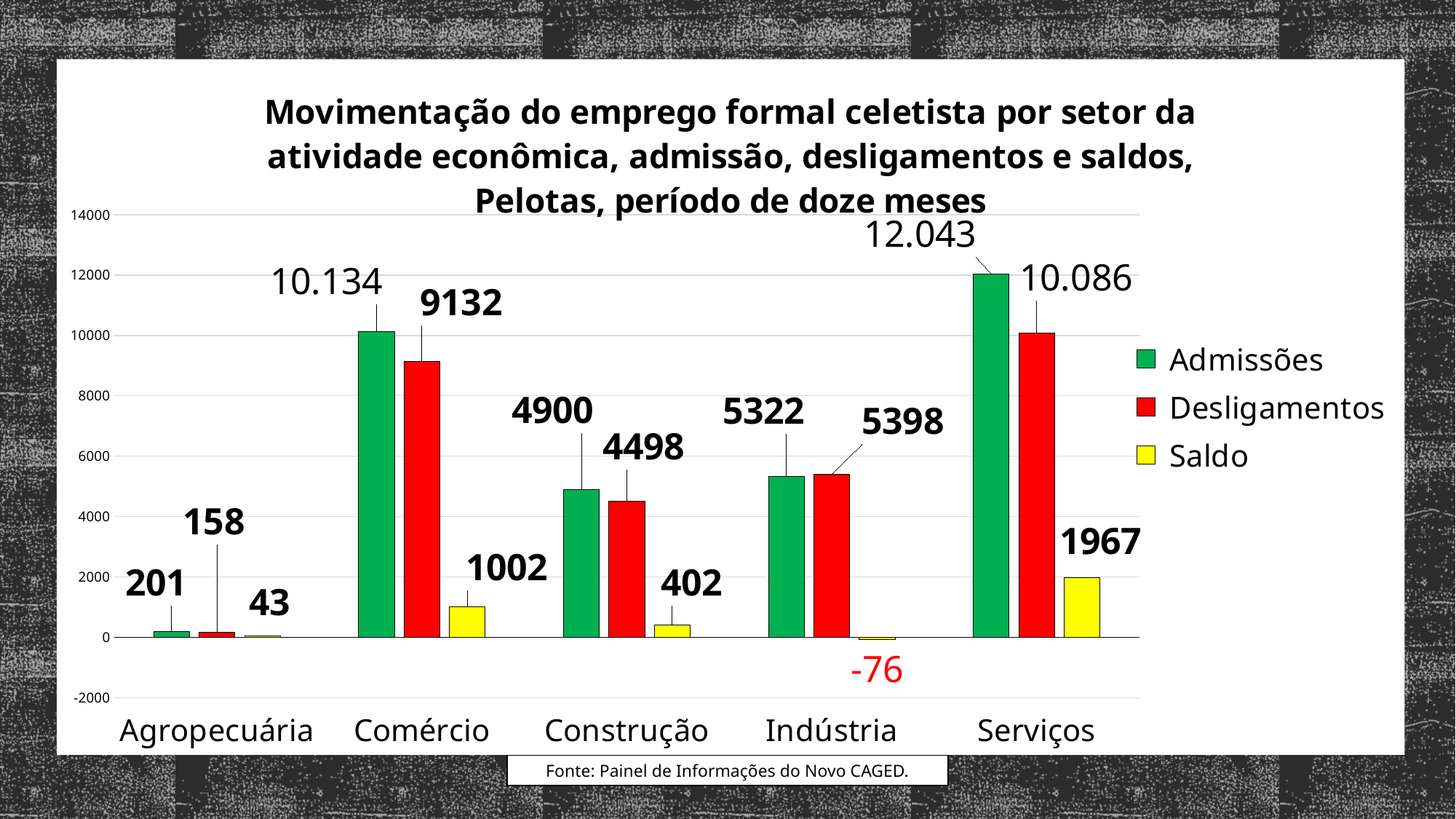
How many sectors are shown on the x axis? 5 What is the value of Desligamentos for Comércio? 9132 For Comércio, which is larger: Admissões or Desligamentos? Admissões What kind of chart is shown on the slide? Bar chart Which sector has the highest Admissões value? Serviços Which sector has the lowest Saldo value? Indústria How many series does the legend list? 3 What is the difference between Admissões and Desligamentos for Construção? 402 What colour represents the Saldo series in the legend? Yellow What is the Saldo value for Indústria? -76 What is the value of Admissões for Serviços? 12.043 What is the Saldo value for Serviços? 1967